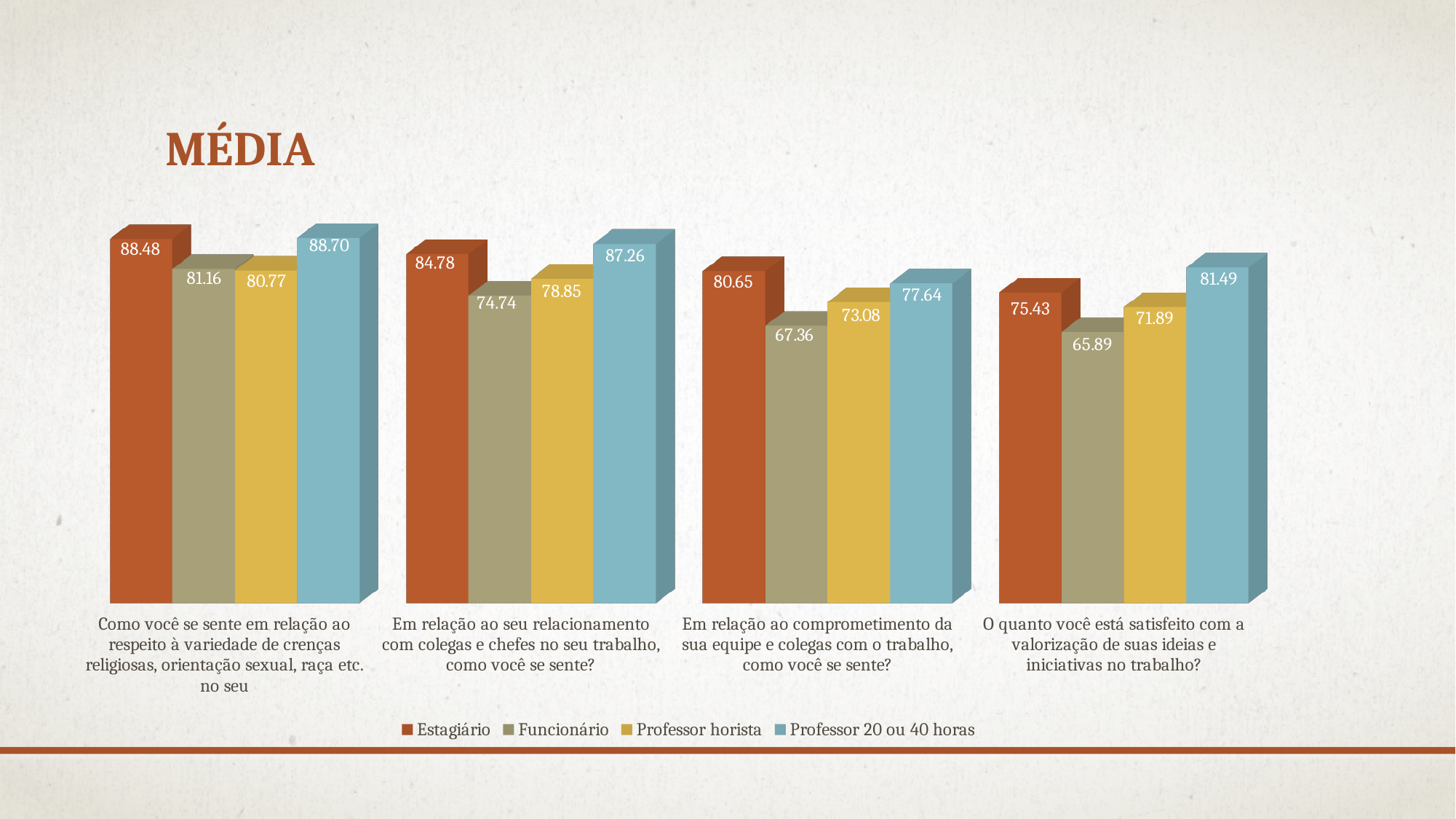
What is the difference between the Estagiário and Funcionário values in the category 'Em relação ao seu relacionamento com colegas e chefes no seu trabalho, como você se sente?' 10.04 Which series has the highest value in the category 'Em relação ao comprometimento da sua equipe e colegas com o trabalho, como você se sente?' Estagiário How many categories are shown on the x axis of the chart? 4 How many series does the legend list? 4 Which series has the lowest value in the category 'O quanto você está satisfeito com a valorização de suas ideias e iniciativas no trabalho?' Funcionário Do the values for Funcionário rise or fall from the first category to the last category along the x axis? Fall In the category 'O quanto você está satisfeito com a valorização de suas ideias e iniciativas no trabalho?', which is larger: the value for Professor horista or the value for Professor 20 ou 40 horas? Professor 20 ou 40 horas What is the value for Professor horista in the category 'Como você se sente em relação ao respeito à variedade de crenças religiosas, orientação sexual, raça etc. no seu'? 80.77 What kind of chart is shown on the slide? Bar chart What is the value for Professor 20 ou 40 horas in the category 'O quanto você está satisfeito com a valorização de suas ideias e iniciativas no trabalho?' 81.49 What is the value for Funcionário in the category 'Em relação ao comprometimento da sua equipe e colegas com o trabalho, como você se sente?' 67.36 What is the value for Estagiário in the category 'Em relação ao seu relacionamento com colegas e chefes no seu trabalho, como você se sente?' 84.78